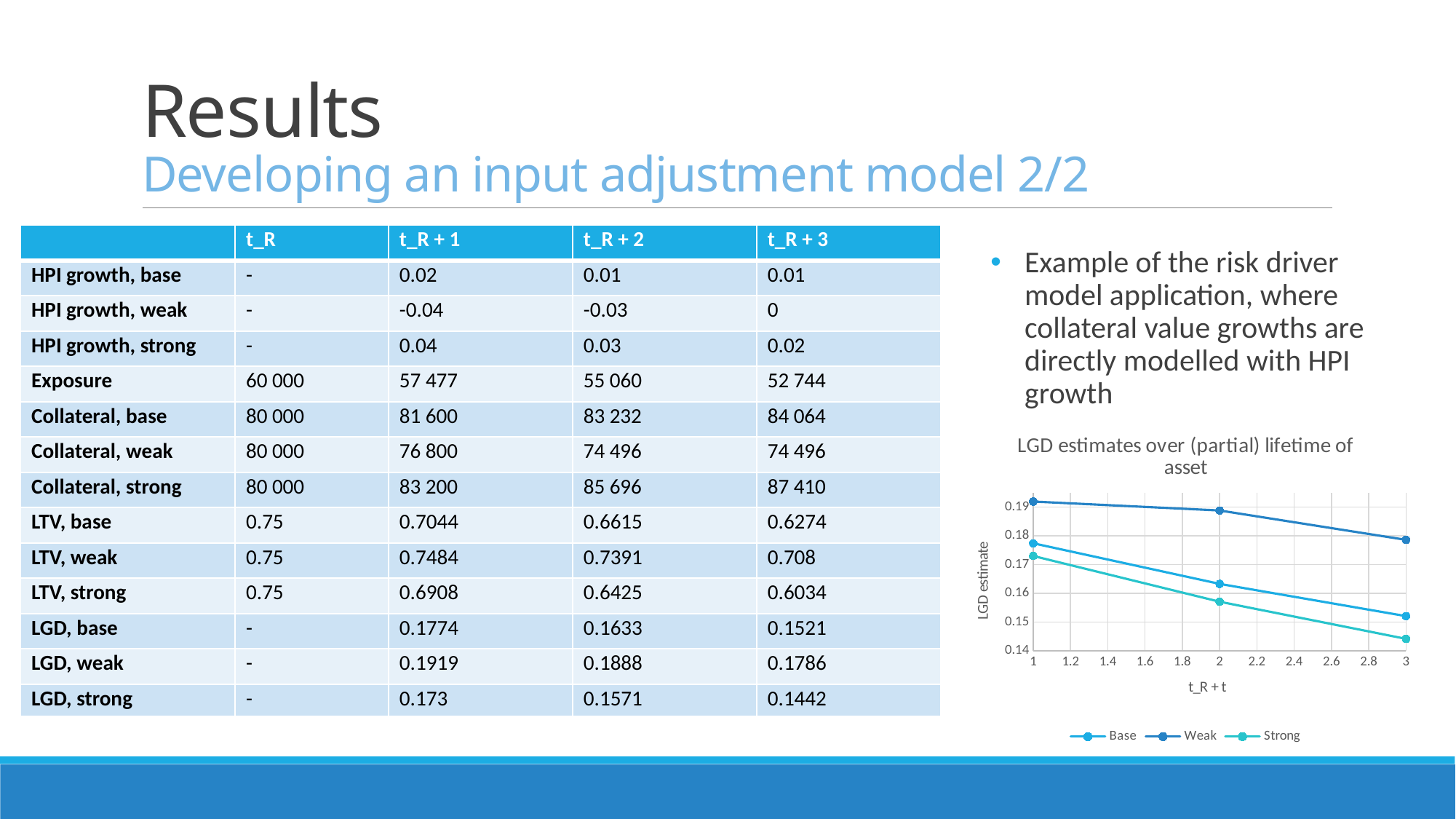
Is the LGD estimate for the Strong series at t_R + t = 3 greater or less than 0.15? less Which series has the lowest LGD estimate at t_R + t = 1? Strong Is the LGD estimate for the Base series at t_R + t = 1 greater or less than 0.18? less What is the label of the chart's vertical axis? LGD estimate What is the title of the chart? LGD estimates over (partial) lifetime of asset At t_R + t = 2, which series has the larger LGD estimate, Base or Strong? Base Which series has the highest LGD estimate at t_R + t = 3? Weak Do the LGD estimates for the Weak series rise or fall as t_R + t increases? fall Is the LGD estimate for the Weak series at t_R + t = 2 greater or less than 0.18? greater How many data points are plotted for the Base series? 3 What kind of chart is shown on the slide? line chart How many series does the legend of the chart list? 3